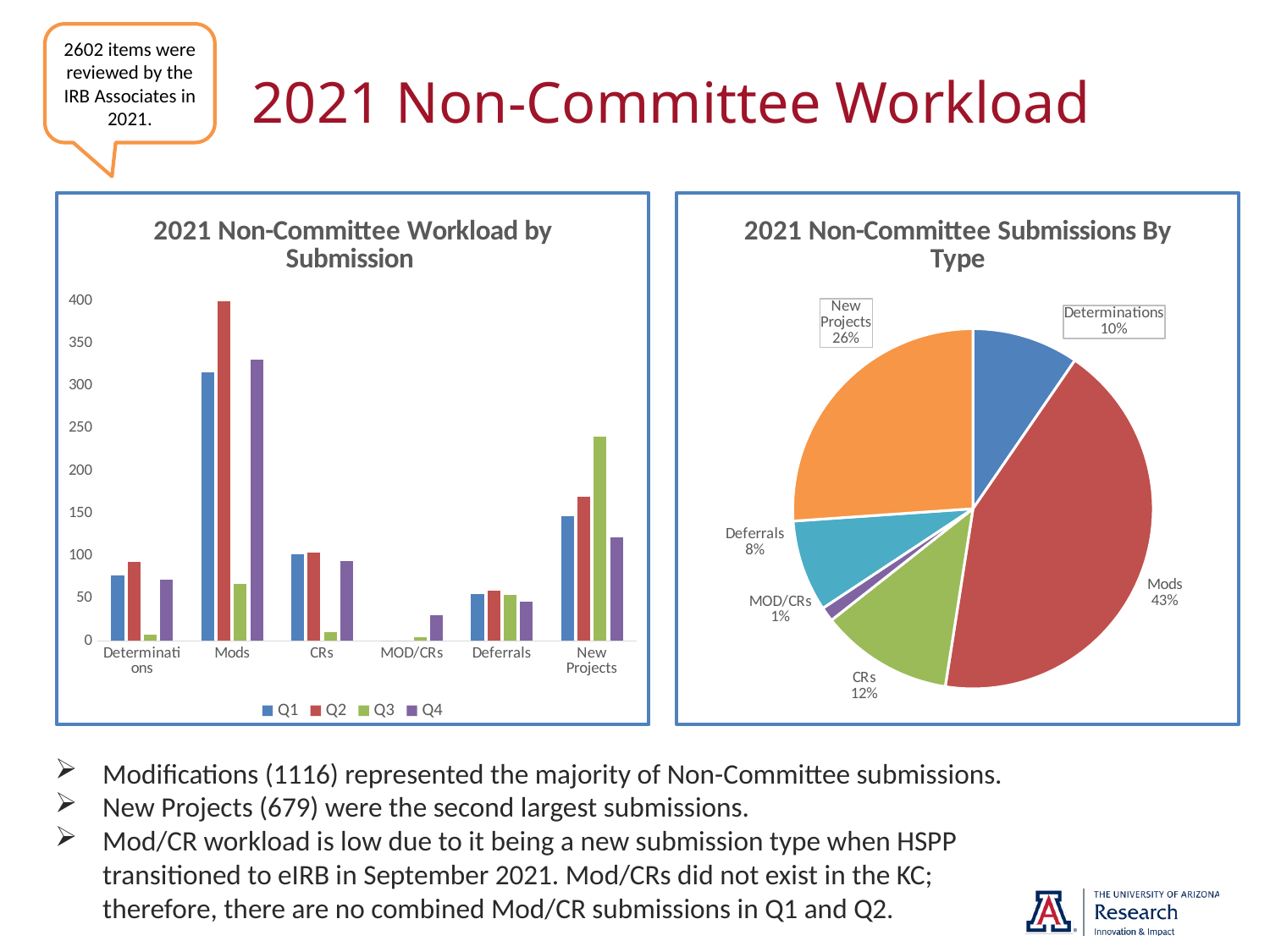
In the '2021 Non-Committee Submissions By Type' pie chart, what share do Mods represent? 43% In the '2021 Non-Committee Workload by Submission' chart, which category has the tallest bar overall? Mods In the '2021 Non-Committee Submissions By Type' pie chart, what percentage is shown for New Projects? 26% In the '2021 Non-Committee Submissions By Type' pie chart, which type has the smallest share? MOD/CRs How many slices does the '2021 Non-Committee Submissions By Type' pie chart have? 6 In the '2021 Non-Committee Workload by Submission' chart, is the Q3 value for Mods greater or less than 100? less In the '2021 Non-Committee Workload by Submission' chart, is the Q2 value for Mods greater or less than 350? greater In the '2021 Non-Committee Submissions By Type' pie chart, which is larger, the share for CRs or the share for Deferrals? CRs How many series does the legend of the '2021 Non-Committee Workload by Submission' chart list? 4 What kind of chart is '2021 Non-Committee Workload by Submission'? Bar chart In the '2021 Non-Committee Submissions By Type' pie chart, how many percentage points larger is the Mods share than the New Projects share? 17 In the '2021 Non-Committee Submissions By Type' pie chart, which type has the largest share? Mods